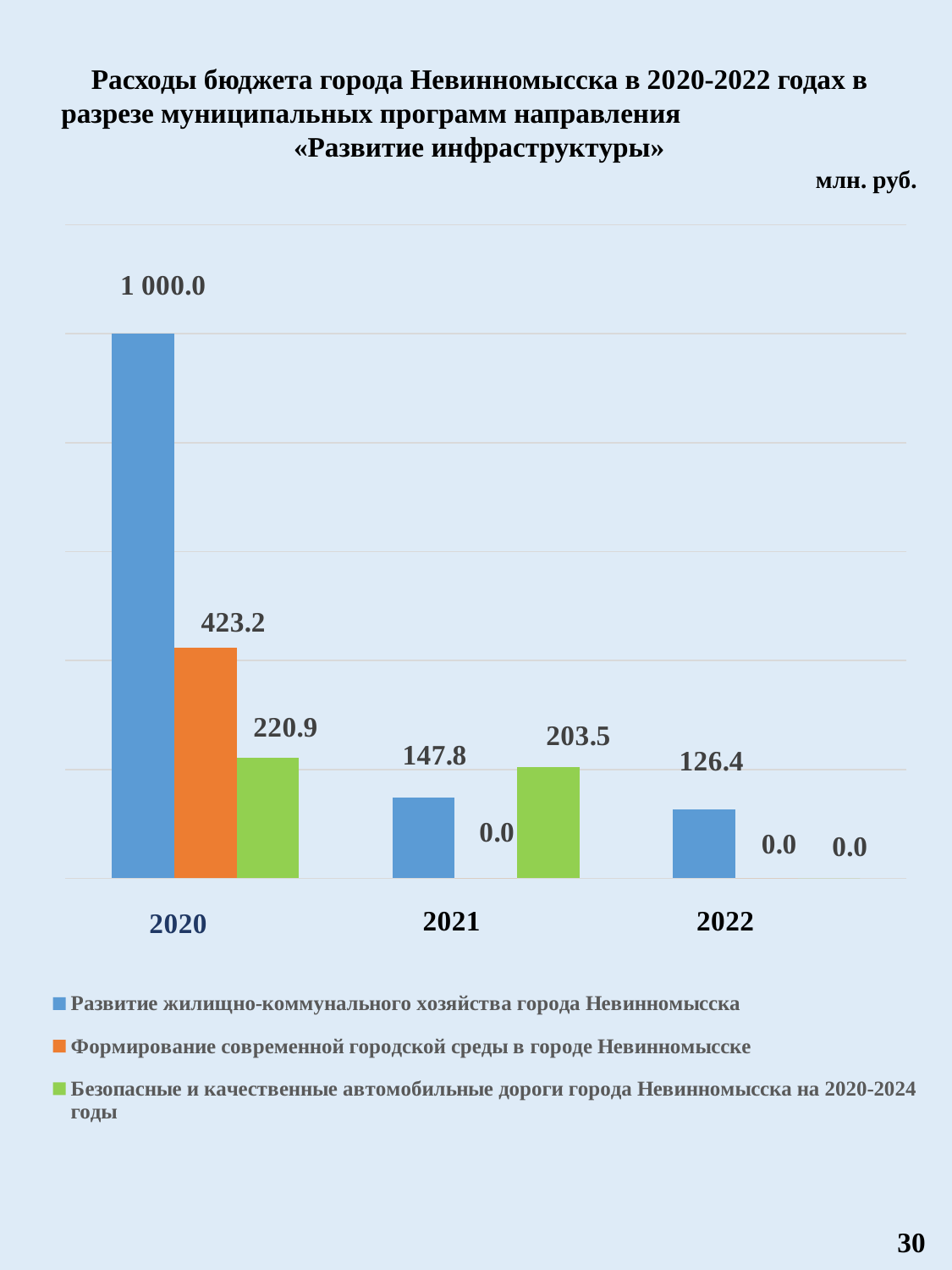
In which year is the value for «Развитие жилищно-коммунального хозяйства города Невинномысска» lowest? 2022 Does the value for «Развитие жилищно-коммунального хозяйства города Невинномысска» rise or fall from 2020 to 2022? Fall How many years are shown on the x axis? 3 In which year is the value for «Развитие жилищно-коммунального хозяйства города Невинномысска» highest? 2020 What is the value for «Развитие жилищно-коммунального хозяйства города Невинномысска» in 2022? 126.4 What is the value for «Развитие жилищно-коммунального хозяйства города Невинномысска» in 2020? 1 000.0 What is the value for «Формирование современной городской среды в городе Невинномысске» in 2020? 423.2 What is the difference between the 2020 and 2021 values for «Развитие жилищно-коммунального хозяйства города Невинномысска»? 852.2 How many series does the legend list? 3 What kind of chart is shown on the slide? Bar chart What is the value for «Безопасные и качественные автомобильные дороги города Невинномысска на 2020-2024 годы» in 2021? 203.5 In 2021, which is larger: «Развитие жилищно-коммунального хозяйства города Невинномысска» or «Безопасные и качественные автомобильные дороги города Невинномысска на 2020-2024 годы»? Безопасные и качественные автомобильные дороги города Невинномысска на 2020-2024 годы